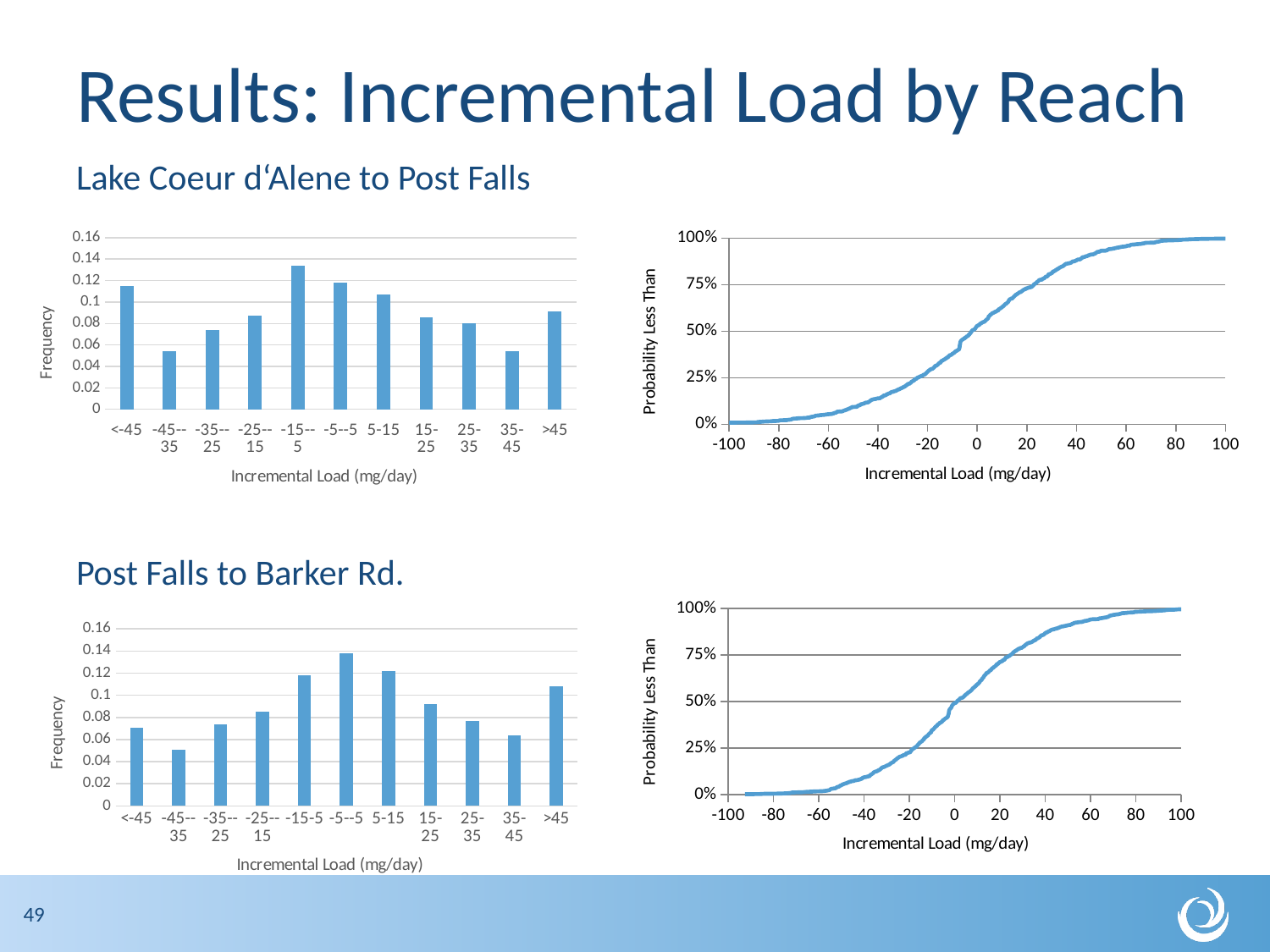
In the Post Falls to Barker Rd. bar chart (bottom left), which incremental load bin has the lowest frequency? -45--35 What kind of chart is the bottom-left chart for Post Falls to Barker Rd.? bar chart In the Lake Coeur d'Alene to Post Falls bar chart (top left), is the frequency for the -45--35 bin greater or less than 0.08? less In the Post Falls to Barker Rd. bar chart (bottom left), which incremental load bin has the highest frequency? -5--5 In the Post Falls to Barker Rd. line chart (bottom right), is the probability at an incremental load of 40 greater or less than 75%? greater In the Post Falls to Barker Rd. line chart (bottom right), does the probability rise or fall as incremental load increases along the x axis? rises How many incremental load bins are shown in the Lake Coeur d'Alene to Post Falls bar chart (top left)? 11 In the Post Falls to Barker Rd. bar chart (bottom left), is the frequency for the >45 bin greater or less than 0.1? greater In the Lake Coeur d'Alene to Post Falls bar chart (top left), which incremental load bin has the highest frequency? -15--5 In the Lake Coeur d'Alene to Post Falls bar chart (top left), which bin has the higher frequency, <-45 or >45? <-45 What kind of chart is the top-right chart for Lake Coeur d'Alene to Post Falls? line chart